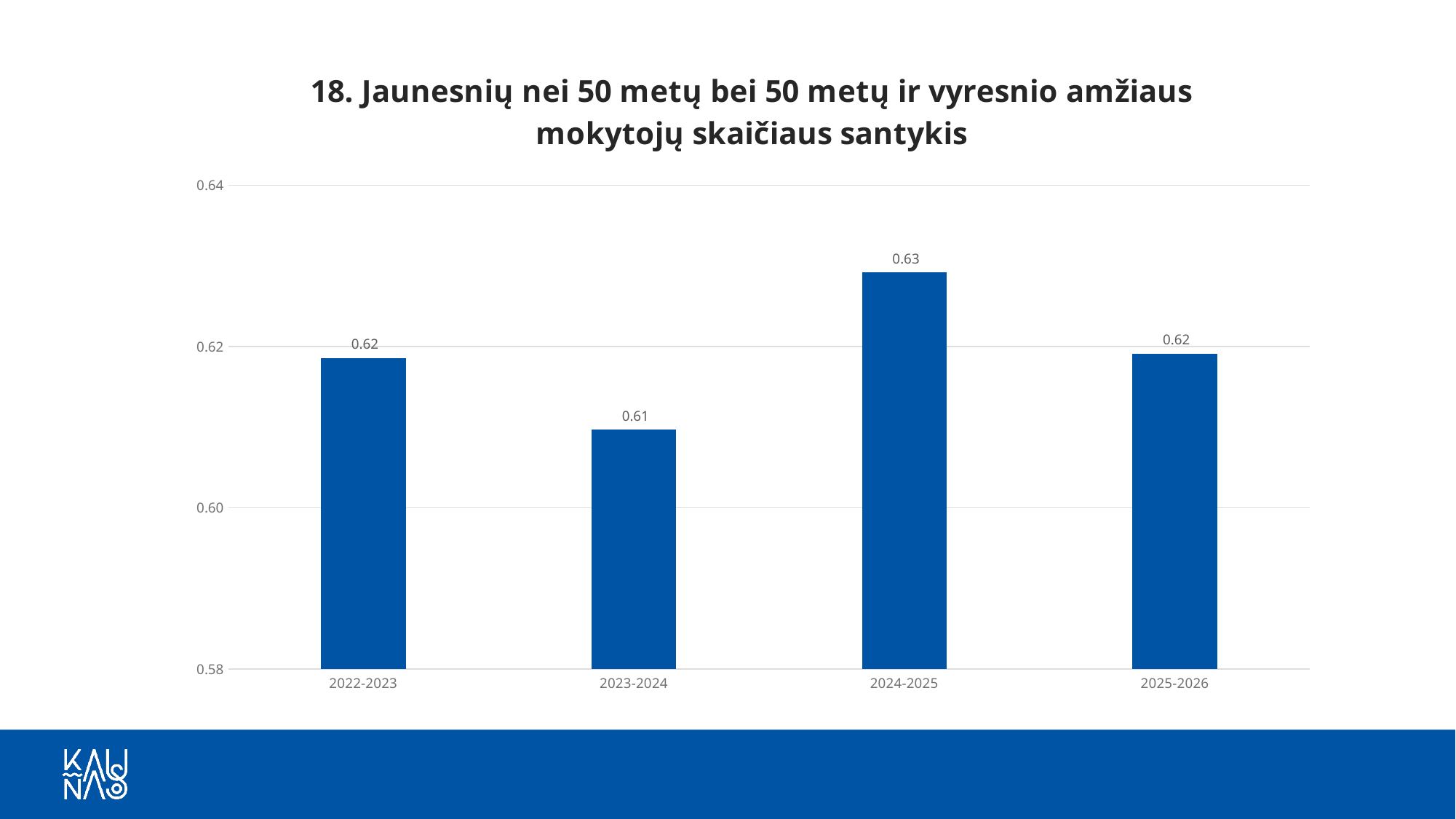
Which school year has the lowest value? 2023-2024 What is the value for 2025-2026? 0.62 Which school year has the highest value? 2024-2025 Is the value for 2023-2024 greater or less than 0.60? greater What is the value for 2022-2023? 0.62 What is the value for 2024-2025? 0.63 What kind of chart is shown on the slide? bar chart Does the value rise or fall from 2023-2024 to 2024-2025? rise Which is larger, the value for 2024-2025 or the value for 2023-2024? 2024-2025 How many school years are shown on the x axis? 4 What is the value for 2023-2024? 0.61 What is the difference between the values for 2024-2025 and 2023-2024? 0.02